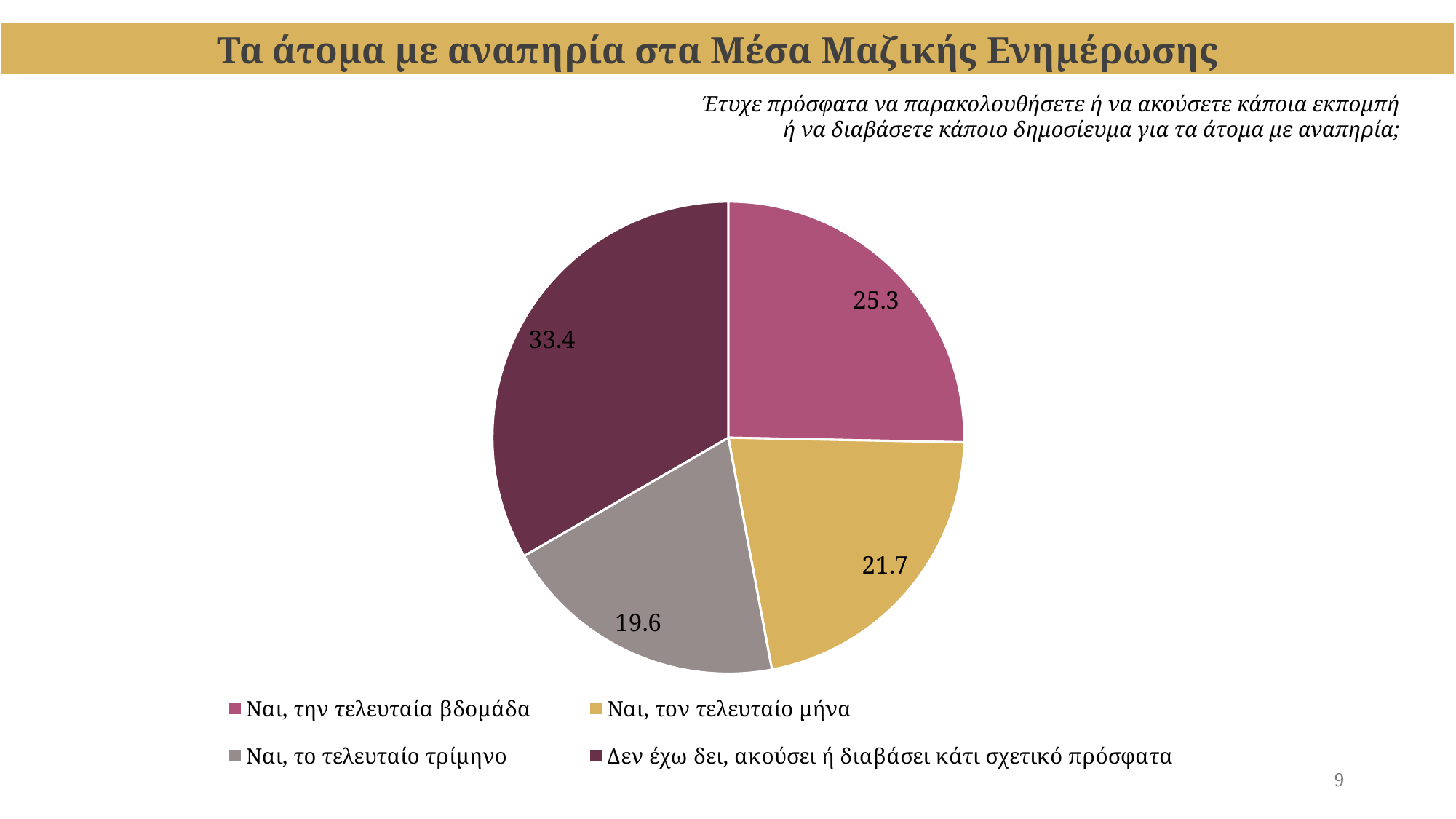
What is the difference between the values for "Ναι, τον τελευταίο μήνα" and "Ναι, το τελευταίο τρίμηνο"? 2.1 What is the value for "Ναι, την τελευταία βδομάδα"? 25.3 Which category has the smallest slice of the pie? Ναι, το τελευταίο τρίμηνο What is the difference between the values for "Δεν έχω δει, ακούσει ή διαβάσει κάτι σχετικό πρόσφατα" and "Ναι, την τελευταία βδομάδα"? 8.1 What is the value for "Ναι, το τελευταίο τρίμηνο"? 19.6 What colour is the slice for "Ναι, τον τελευταίο μήνα"? gold/yellow What kind of chart is shown on the slide? pie chart Which is larger: the value for "Ναι, την τελευταία βδομάδα" or the value for "Ναι, τον τελευταίο μήνα"? Ναι, την τελευταία βδομάδα Which category has the largest slice of the pie? Δεν έχω δει, ακούσει ή διαβάσει κάτι σχετικό πρόσφατα How many slices does the pie chart have? 4 What is the value for "Δεν έχω δει, ακούσει ή διαβάσει κάτι σχετικό πρόσφατα"? 33.4 What is the value for "Ναι, τον τελευταίο μήνα"? 21.7